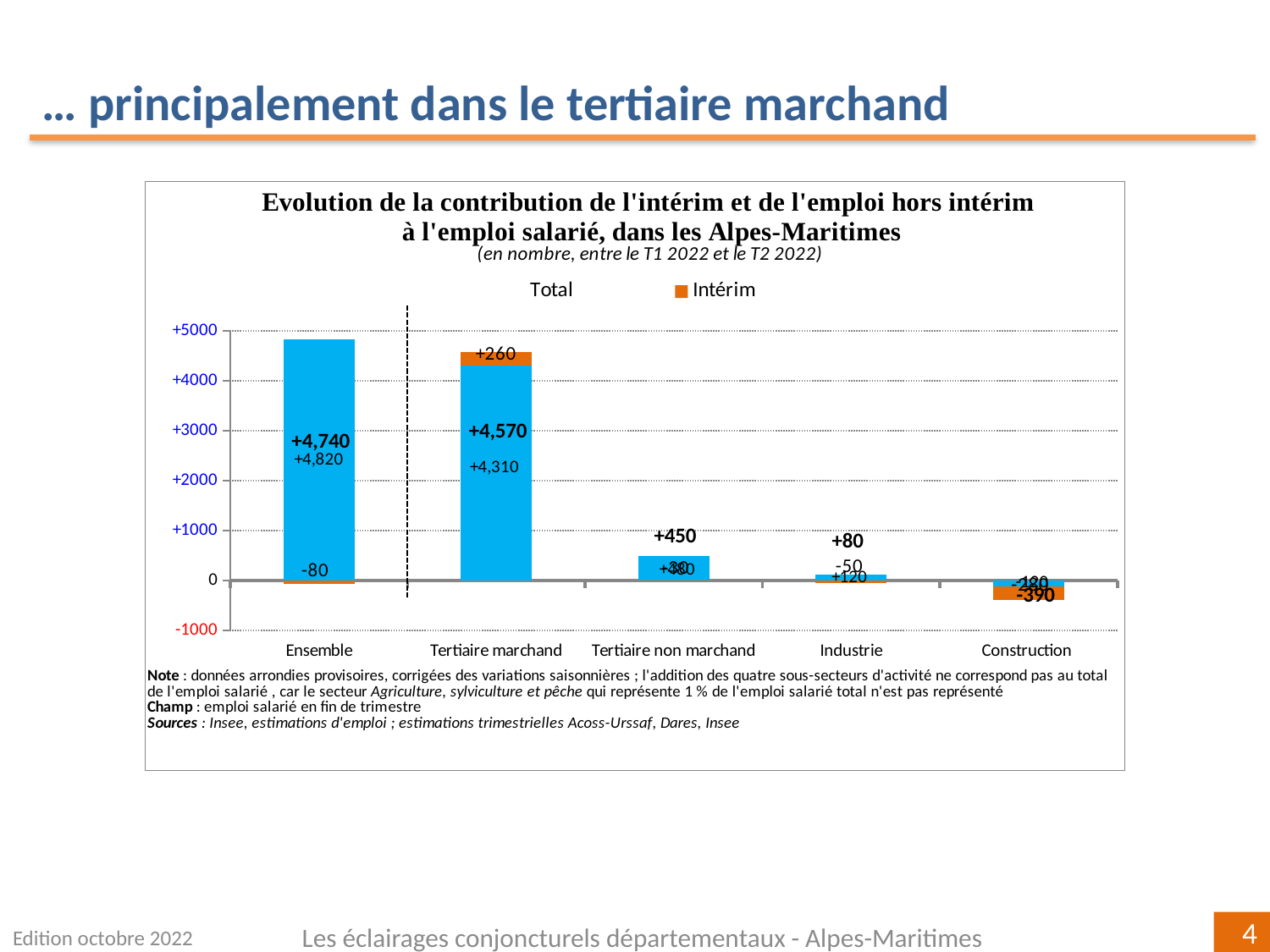
How many categories are shown on the x axis of the chart? 5 What is the total value labelled for Ensemble? +4,740 How many series does the chart legend list? 2 What is the difference between the total for Ensemble (+4,740) and the total for Tertiaire marchand (+4,570)? 170 Which has the larger total value, Tertiaire non marchand or Industrie? Tertiaire non marchand What is the Intérim value labelled for Ensemble? -80 Is the total value for Tertiaire non marchand greater or less than +1000? less What is the Intérim value labelled for Tertiaire marchand? +260 What kind of chart is shown on the slide? bar chart What is the total value labelled for Construction? -390 What is the total value labelled for Tertiaire marchand? +4,570 Which category has the lowest total value? Construction